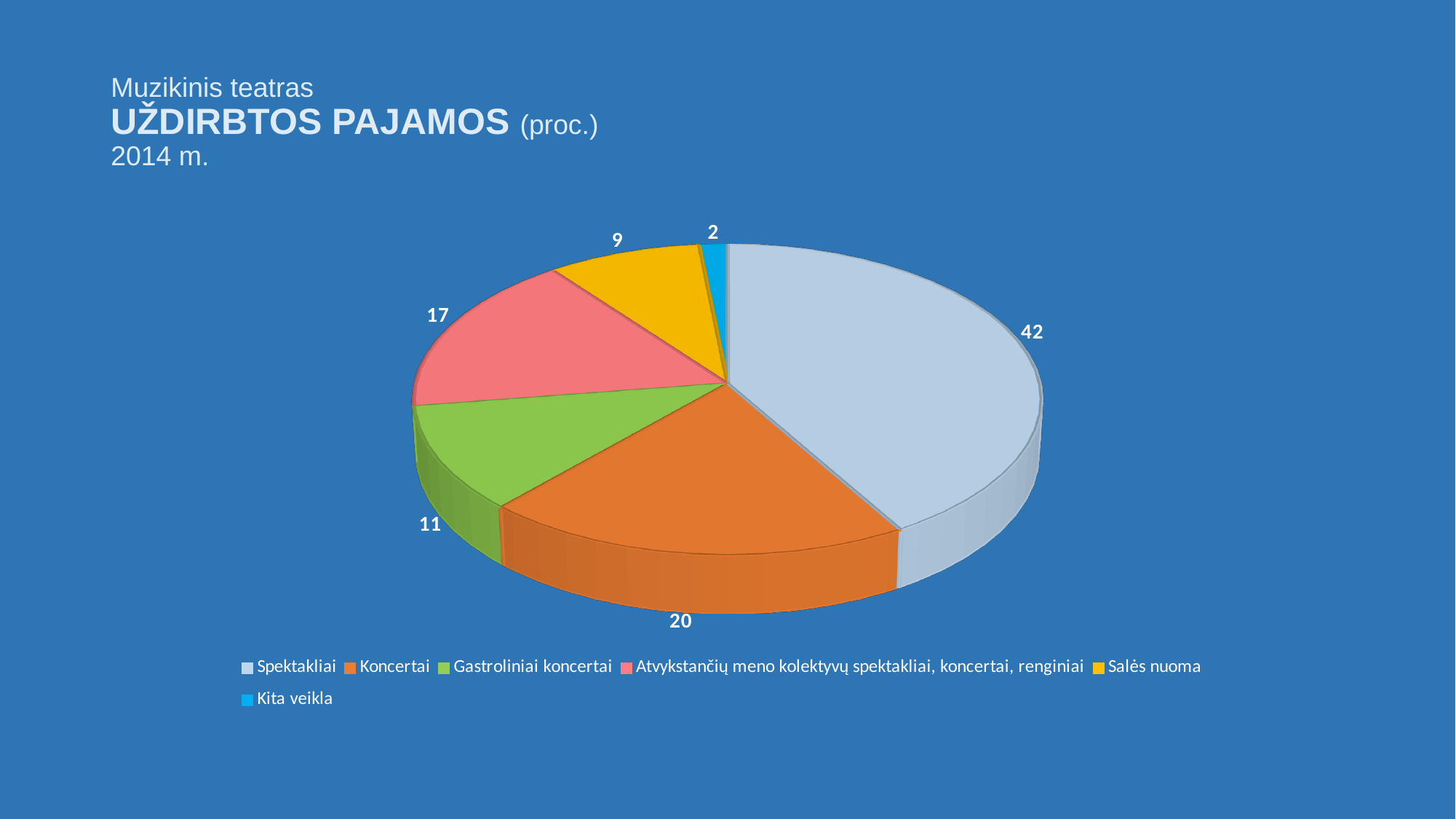
What is the difference between the values for Spektakliai and Koncertai? 22 What is the value for Kita veikla? 2 What is the value for Spektakliai? 42 What is the value for Koncertai? 20 What is the value for Salės nuoma? 9 What is the value for Gastroliniai koncertai? 11 Which is larger, the value for Atvykstančių meno kolektyvų spektakliai, koncertai, renginiai or the value for Gastroliniai koncertai? Atvykstančių meno kolektyvų spektakliai, koncertai, renginiai How many categories does the pie chart have? 6 Which category has the smallest slice of the pie? Kita veikla What kind of chart is shown on the slide? pie chart Which year does the chart title refer to? 2014 m. Which category has the largest slice of the pie? Spektakliai